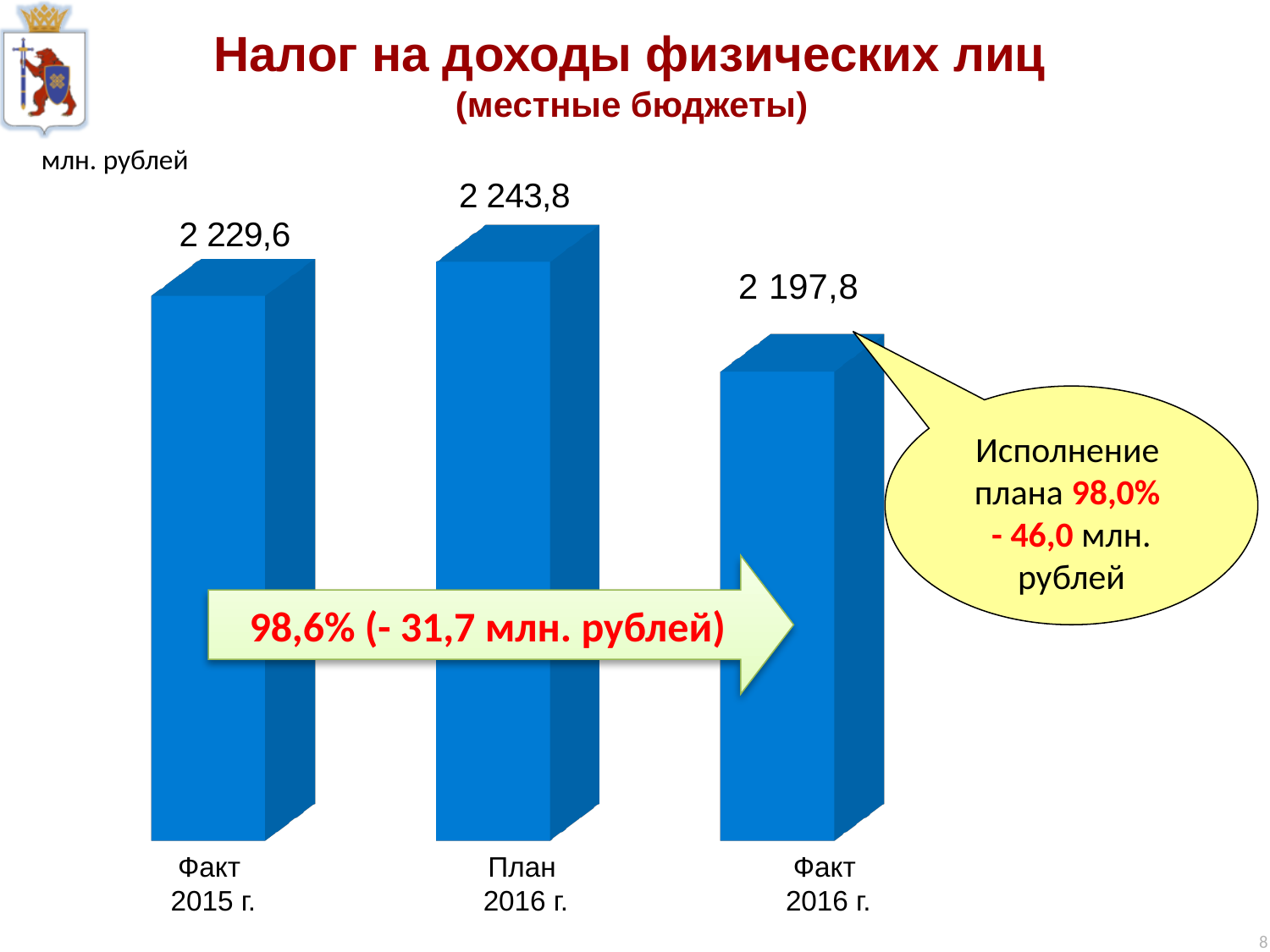
What is the difference between План 2016 г. and Факт 2015 г.? 14,2 Which category has the lowest value? Факт 2016 г. What unit of measurement is indicated for the chart values? млн. рублей Which category has the highest value? План 2016 г. What is the value for Факт 2015 г.? 2 229,6 What is the title of the chart? Налог на доходы физических лиц (местные бюджеты) How many bars are shown in the chart? 3 What kind of chart is shown on the slide? Bar chart What is the difference between План 2016 г. and Факт 2016 г.? 46,0 What is the value for Факт 2016 г.? 2 197,8 What is the value for План 2016 г.? 2 243,8 Which is larger, Факт 2015 г. or Факт 2016 г.? Факт 2015 г.